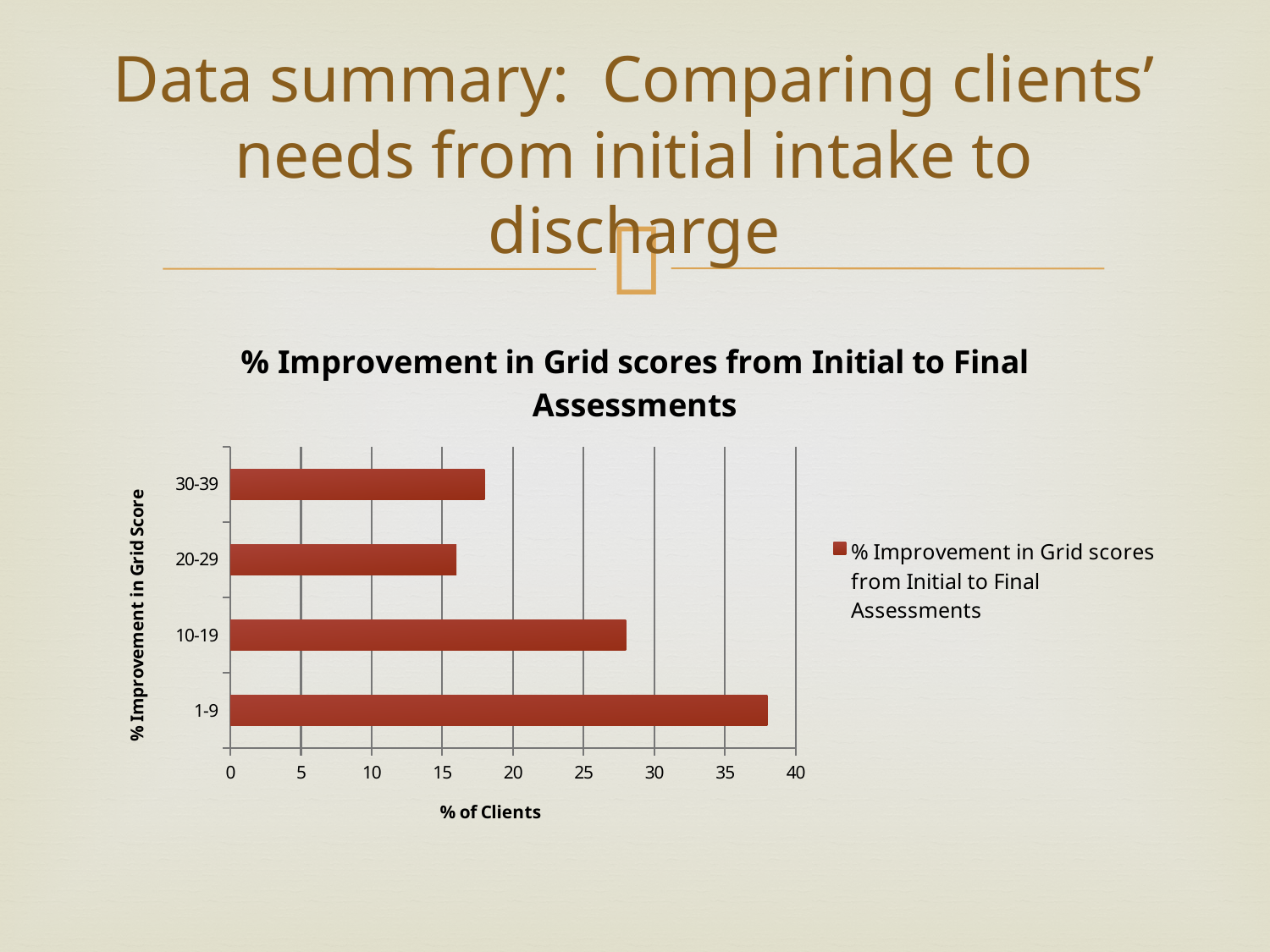
Is the value for the 10-19 category greater or less than 25? greater Is the value for the 1-9 category greater or less than 35? greater What kind of chart is shown on the slide? bar chart Which has a higher % of clients, the 10-19 category or the 20-29 category? 10-19 What is the title of the chart? % Improvement in Grid scores from Initial to Final Assessments What is the label of the horizontal axis of the chart? % of Clients How many series does the chart legend list? 1 Which grid score improvement category has the highest % of clients? 1-9 Is the value for the 30-39 category greater or less than 20? less How many categories of grid score improvement are plotted on the chart? 4 Which has a higher % of clients, the 1-9 category or the 10-19 category? 1-9